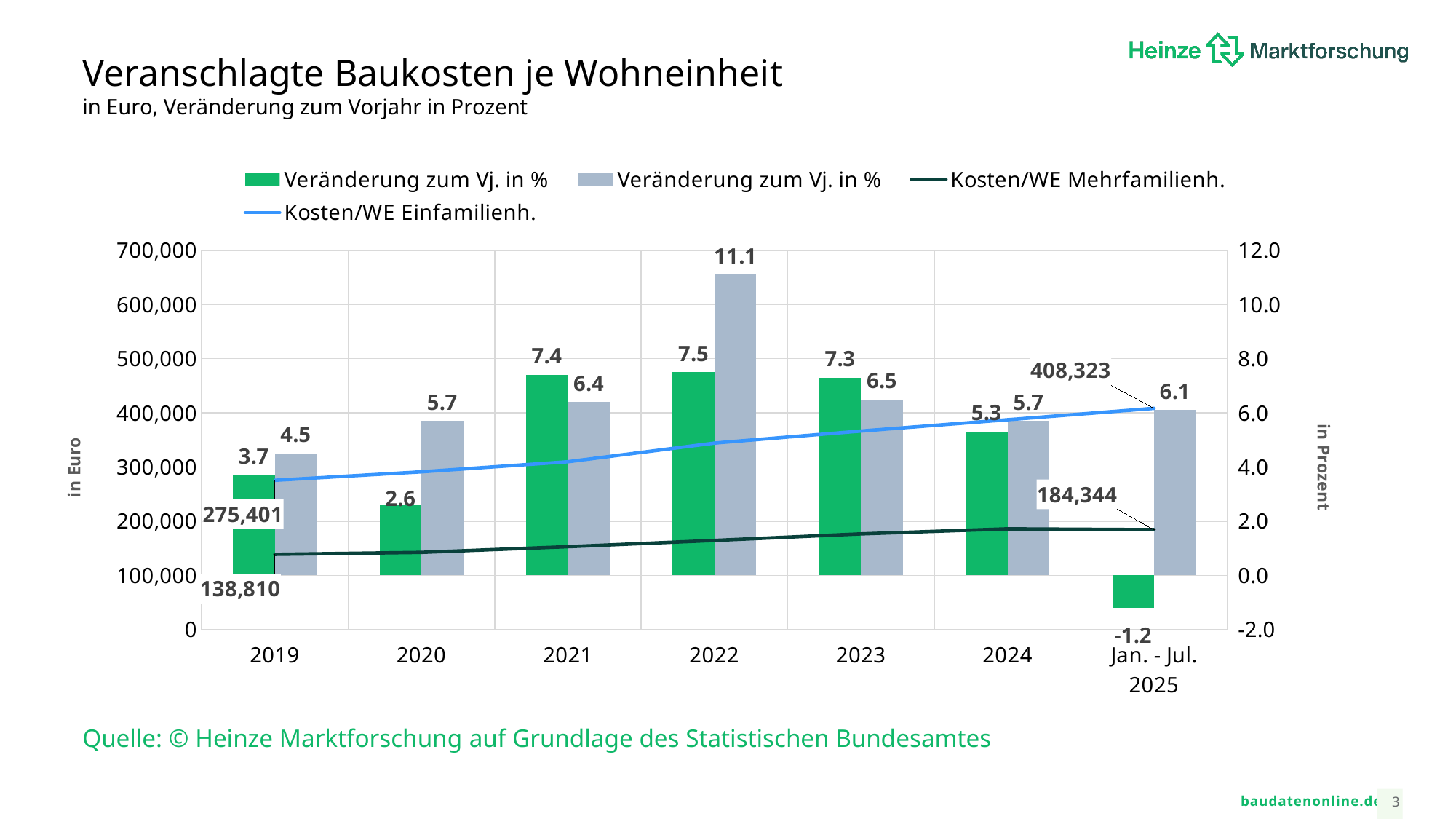
What is the value of Kosten/WE Einfamilienh. in 2019? 275,401 What is the value of Kosten/WE Mehrfamilienh. for Jan. - Jul. 2025? 184,344 What is the value of the green bar for 2022? 7.5 How many periods are shown on the x axis? 7 What is the difference between the grey bar and the green bar in 2022? 3.6 How many series does the legend list? 4 For which period is the green bar (Veränderung zum Vj. in %) lowest? Jan. - Jul. 2025 What kind of chart is this? a combined bar and line chart Does the Kosten/WE Einfamilienh. line rise or fall from 2019 to Jan. - Jul. 2025? rise In 2021, which bar is larger, the green bar or the grey bar? the green bar In which year is the grey bar (Veränderung zum Vj. in %) highest? 2022 What is the value of the grey bar for 2022? 11.1